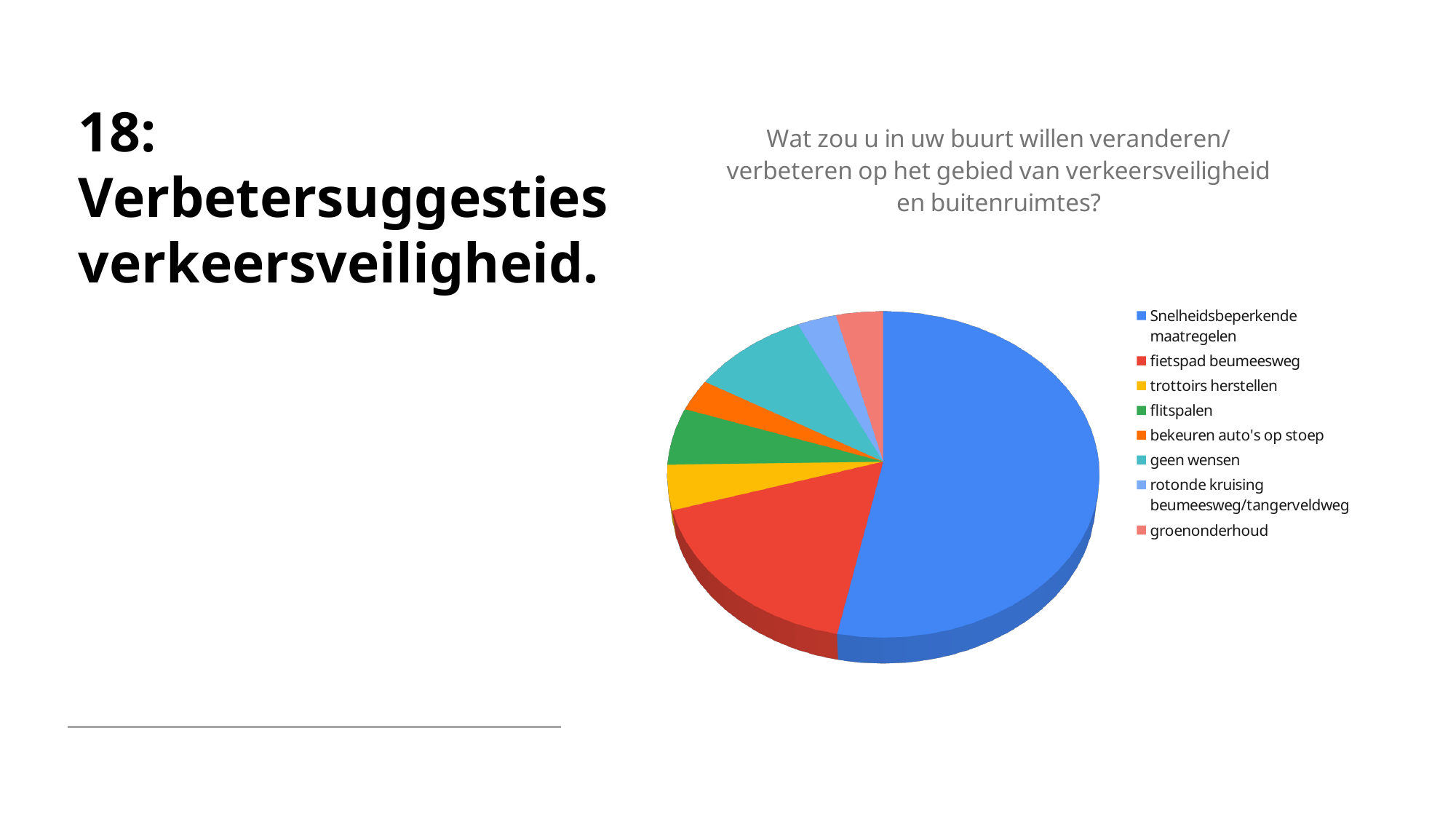
Which slice is larger: fietspad beumeesweg or trottoirs herstellen? fietspad beumeesweg Which category has the largest slice in the pie chart? Snelheidsbeperkende maatregelen Which slice is larger: Snelheidsbeperkende maatregelen or fietspad beumeesweg? Snelheidsbeperkende maatregelen How many entries does the legend of the pie chart list? 8 Does the slice for Snelheidsbeperkende maatregelen cover more or less than half of the pie? more How many categories (slices) does the pie chart have? 8 What colour is the slice for fietspad beumeesweg in the pie chart? red What kind of chart is shown on the slide? pie chart What is the title of the pie chart? Wat zou u in uw buurt willen veranderen/ verbeteren op het gebied van verkeersveiligheid en buitenruimtes?